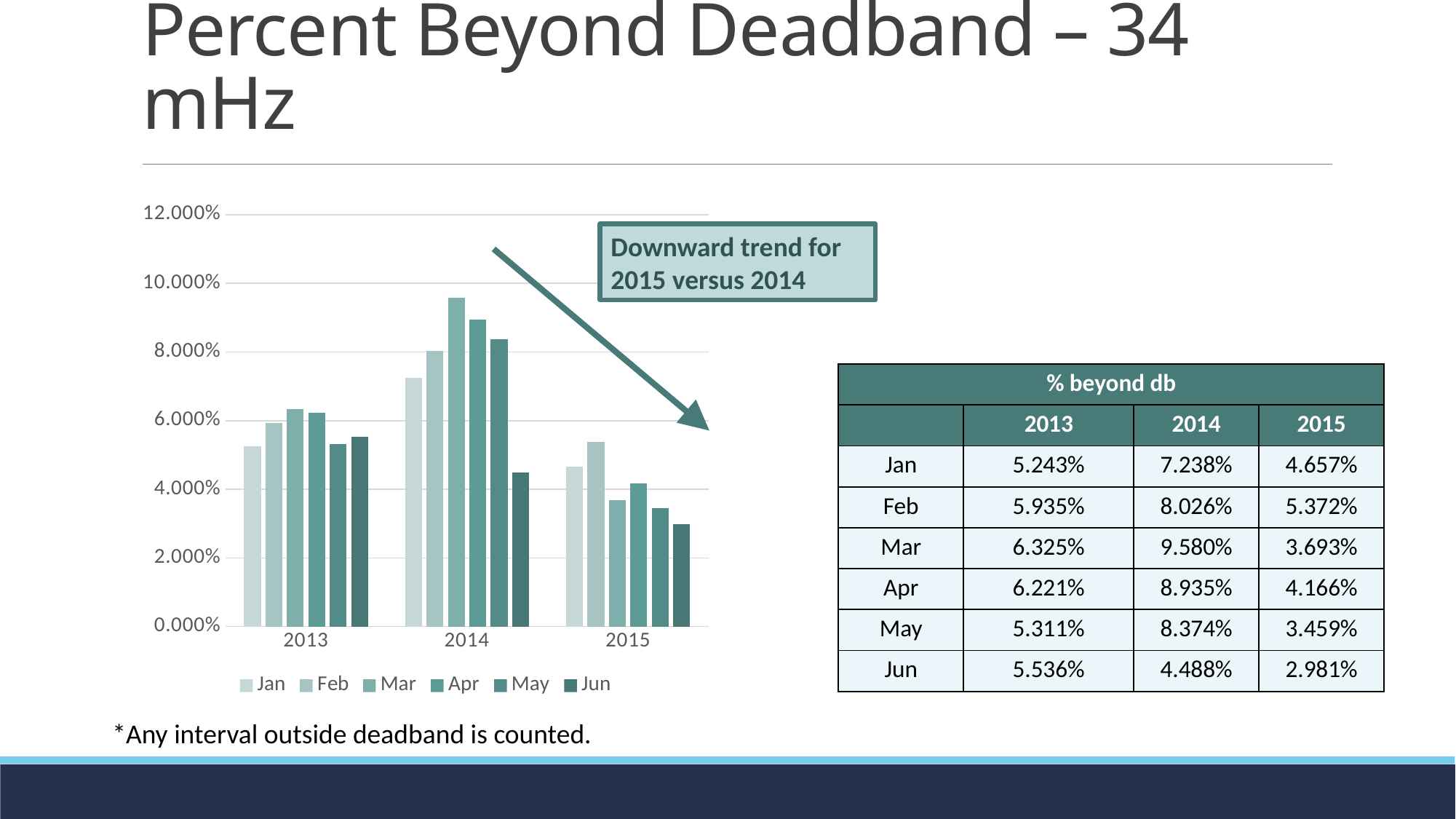
Which month has the lowest % beyond db in 2015? Jun Is the value for Jun 2015 greater or less than 4.000%? less Is the value for Mar 2014 greater or less than 8.000%? greater According to the table, what is the % beyond db for Mar 2014? 9.580% Which is larger, the Jan value for 2014 or the Jan value for 2015? 2014 According to the table, what is the % beyond db for Jun 2015? 2.981% What is the difference between the Mar values for 2014 and 2015 shown in the table? 5.887% What kind of chart is shown on the slide? bar chart How many series does the chart legend list? 6 What does the callout box on the chart say? Downward trend for 2015 versus 2014 Which month has the highest % beyond db in 2014? Mar How many year categories are shown on the x axis of the chart? 3